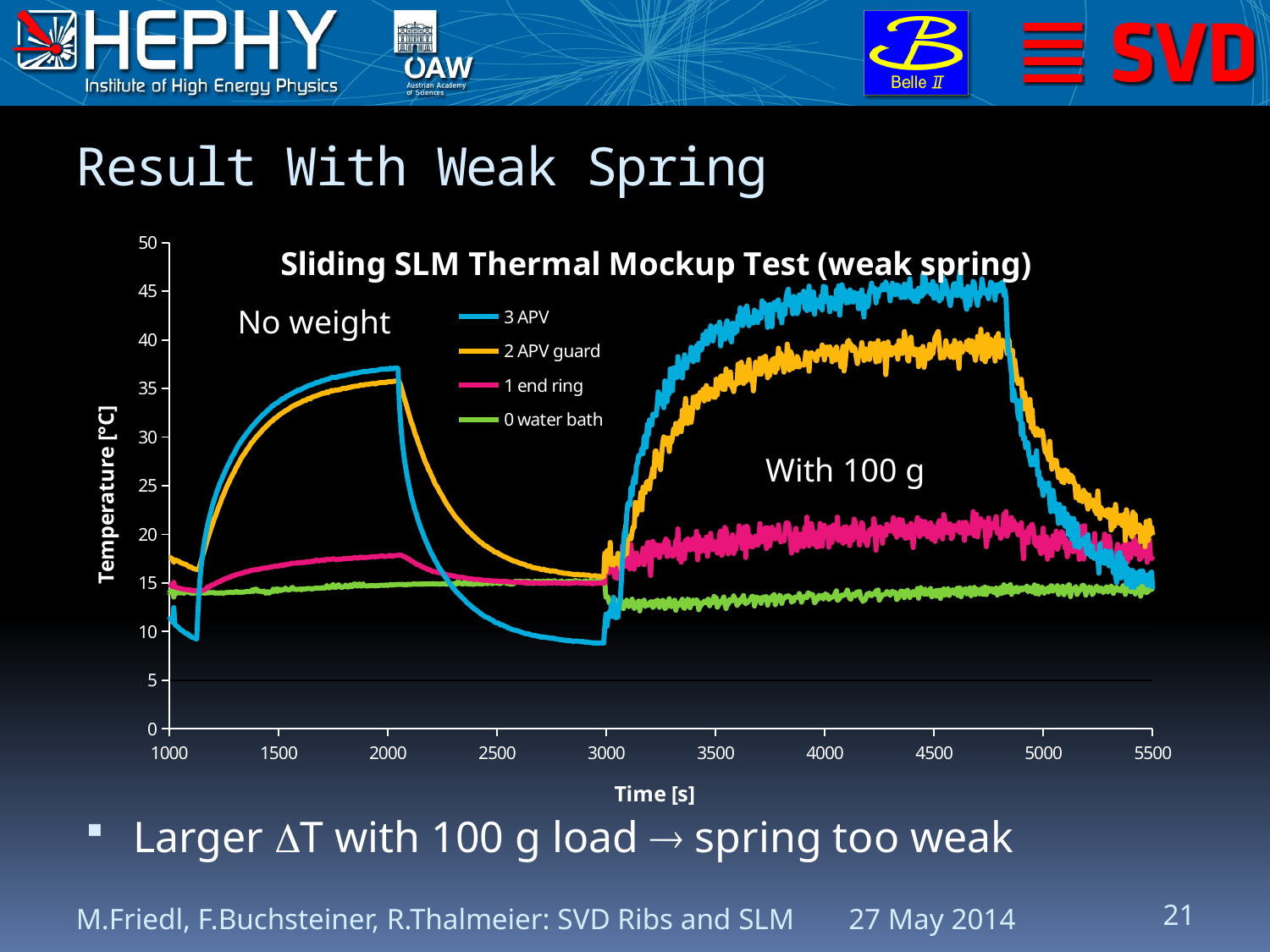
What is the title of the chart? Sliding SLM Thermal Mockup Test (weak spring) What is the label of the vertical axis of the chart? Temperature [°C] What kind of chart is shown on the slide? line chart How many series does the chart legend list? 4 Between 2000 s and 3000 s, does the 3 APV series rise or fall? fall Is the peak value of the 3 APV series during the 'No weight' phase (around 2000 s) greater or less than 30? greater Is the value of the 1 end ring series at 4000 s greater or less than 25? less Which series stays lowest over most of the chart? 0 water bath Is the 0 water bath series greater or less than 20 throughout the chart? less At 4000 s, which series has the higher temperature: 3 APV or 2 APV guard? 3 APV Which series reaches the highest temperature on the chart? 3 APV